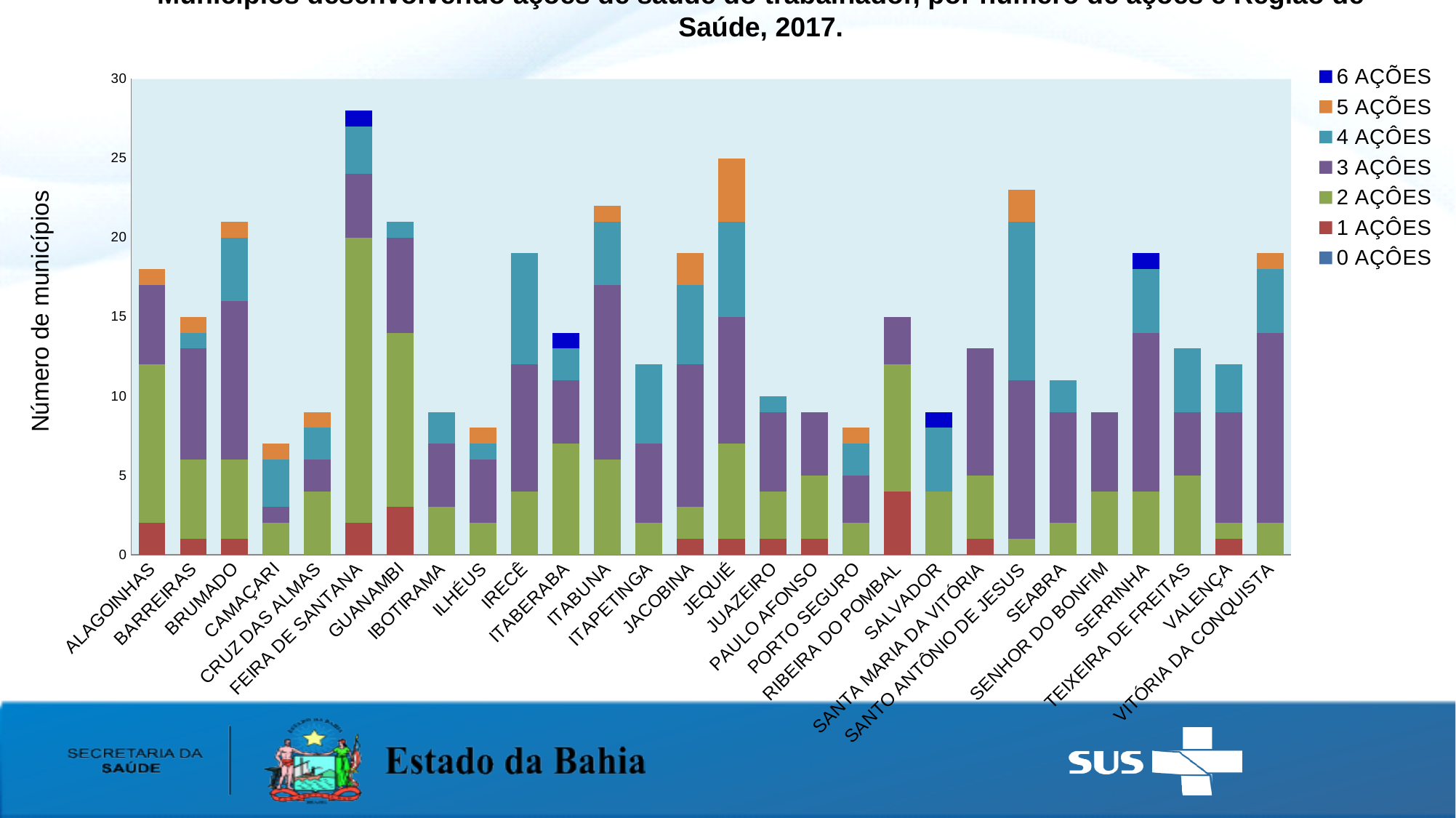
Which region has the tallest stacked bar? FEIRA DE SANTANA What kind of chart is shown on the slide? Stacked bar chart Is the total for CAMAÇARI greater or less than 10? less What is the total height of the stacked bar for RIBEIRA DO POMBAL? 15 Is the total for SANTO ANTÔNIO DE JESUS greater or less than 20? greater What is the total height of the stacked bar for JUAZEIRO? 10 What is the total height of the stacked bar for JEQUIÉ? 25 How many series does the legend list? 7 Which has the taller stacked bar, IRECÊ or SEABRA? IRECÊ What is the label of the y axis? Número de municípios How many health regions (categories) are shown on the x axis? 28 Is the total for FEIRA DE SANTANA greater or less than 25? greater